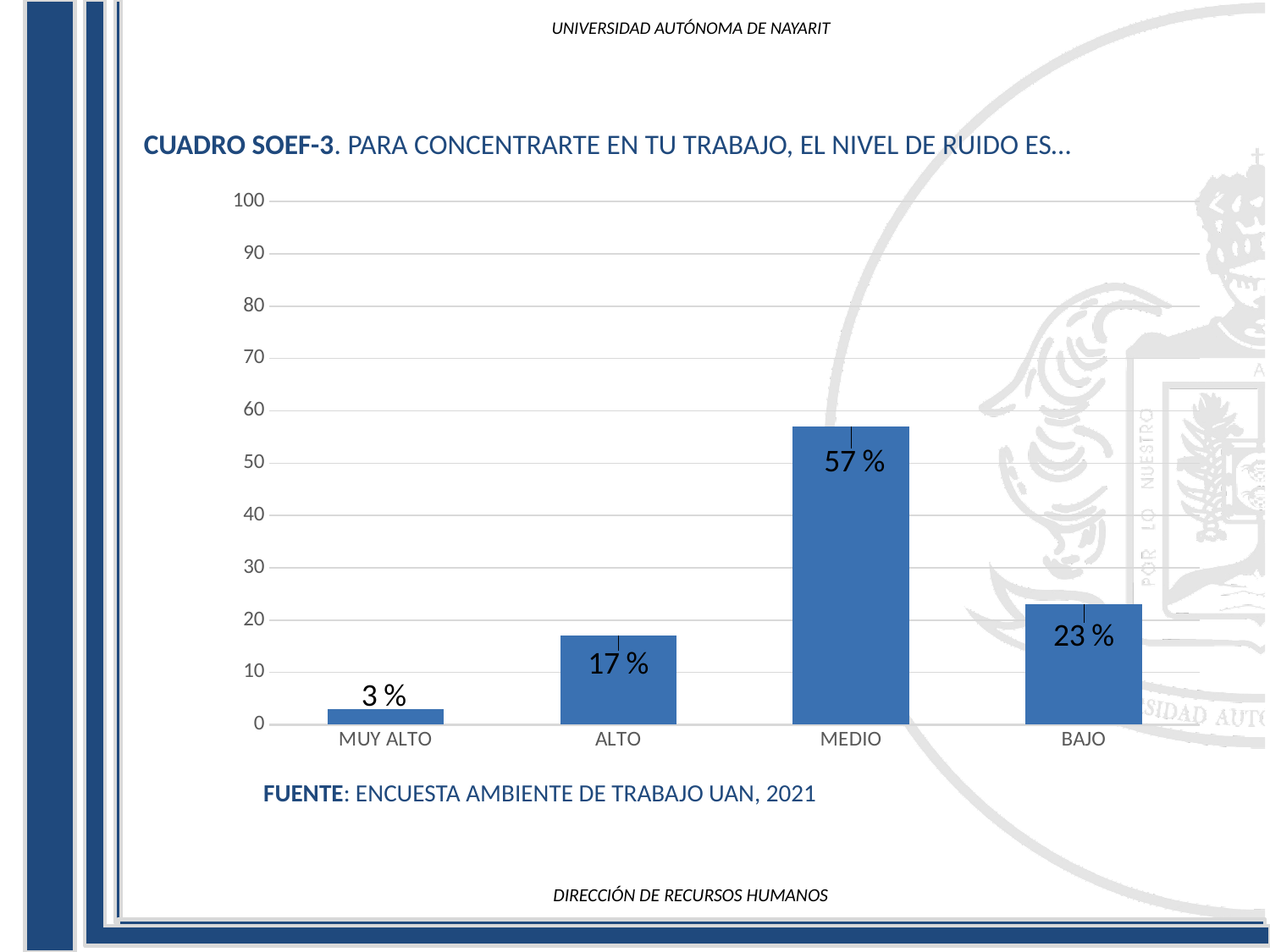
What is the value for ALTO? 17 % What kind of chart is shown on the slide? bar chart What source is cited below the chart? ENCUESTA AMBIENTE DE TRABAJO UAN, 2021 Which category has the highest value? MEDIO What is the value for MUY ALTO? 3 % What is the value for MEDIO? 57 % What is the value for BAJO? 23 % Which is larger, the value for ALTO or the value for BAJO? BAJO Is the value for MEDIO greater or less than 50? greater What is the difference between the values for MEDIO and BAJO? 34 % Which category has the lowest value? MUY ALTO How many categories are shown on the x axis? 4